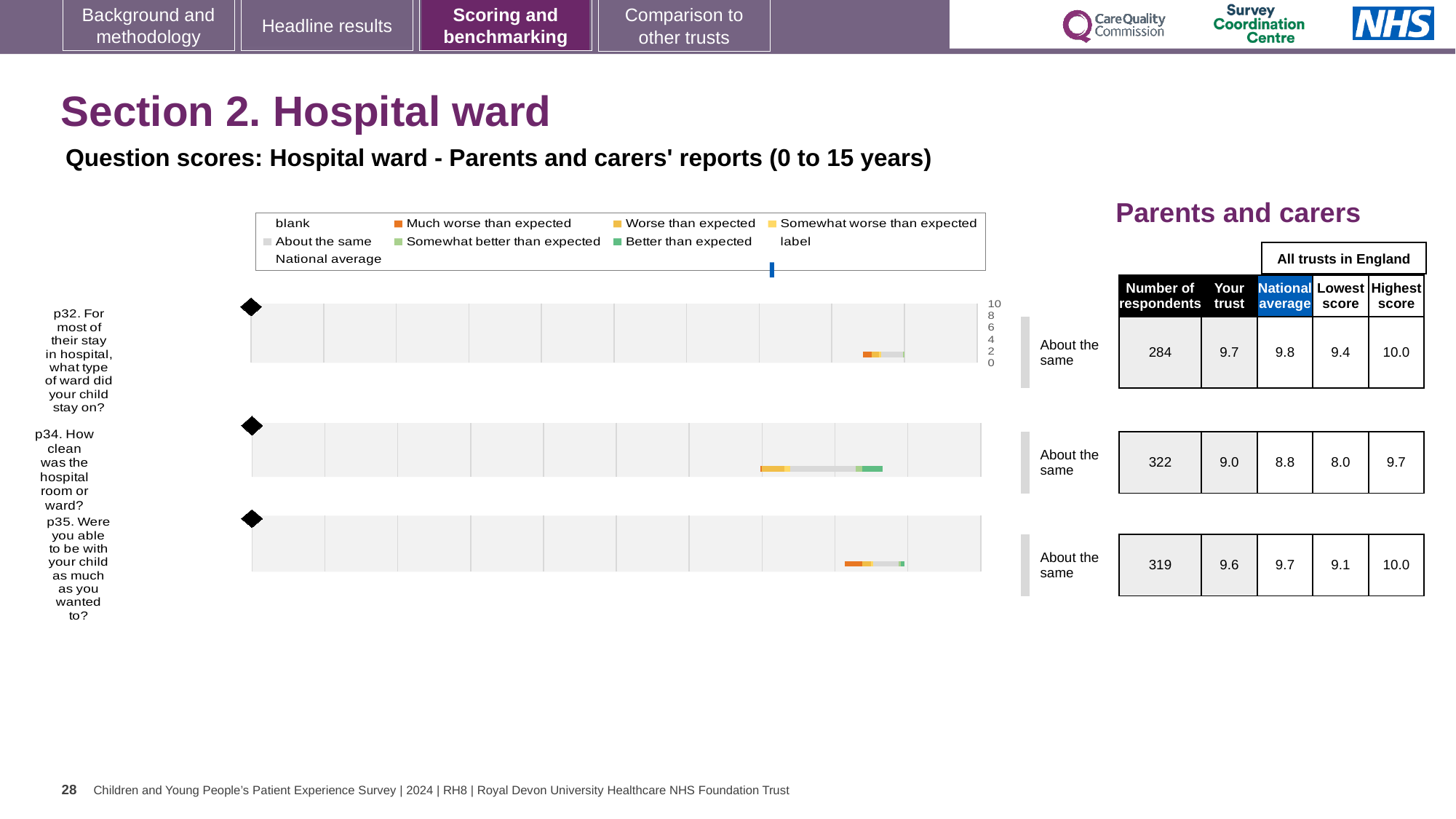
For p35, what is the difference between the highest score and the lowest score across all trusts in England? 0.9 In the chart legend, what colour represents 'Better than expected'? green Which question has the highest 'Your trust' score? p32 For p34, which is larger: the 'Your trust' score or the national average? Your trust In the chart legend, what colour represents 'Much worse than expected'? orange What is the 'Your trust' score for p34 (How clean was the hospital room or ward?)? 9.0 What is the national average score for p32 (For most of their stay in hospital, what type of ward did your child stay on?)? 9.8 What kind of chart is used to show the question scores for p32, p34 and p35? bar chart Which question has the lowest 'Your trust' score? p34 How many respondents answered p35 (Were you able to be with your child as much as you wanted to?)? 319 How many questions are plotted in the question scores chart? 3 What benchmark category is shown next to the chart for p34 (How clean was the hospital room or ward?)? About the same